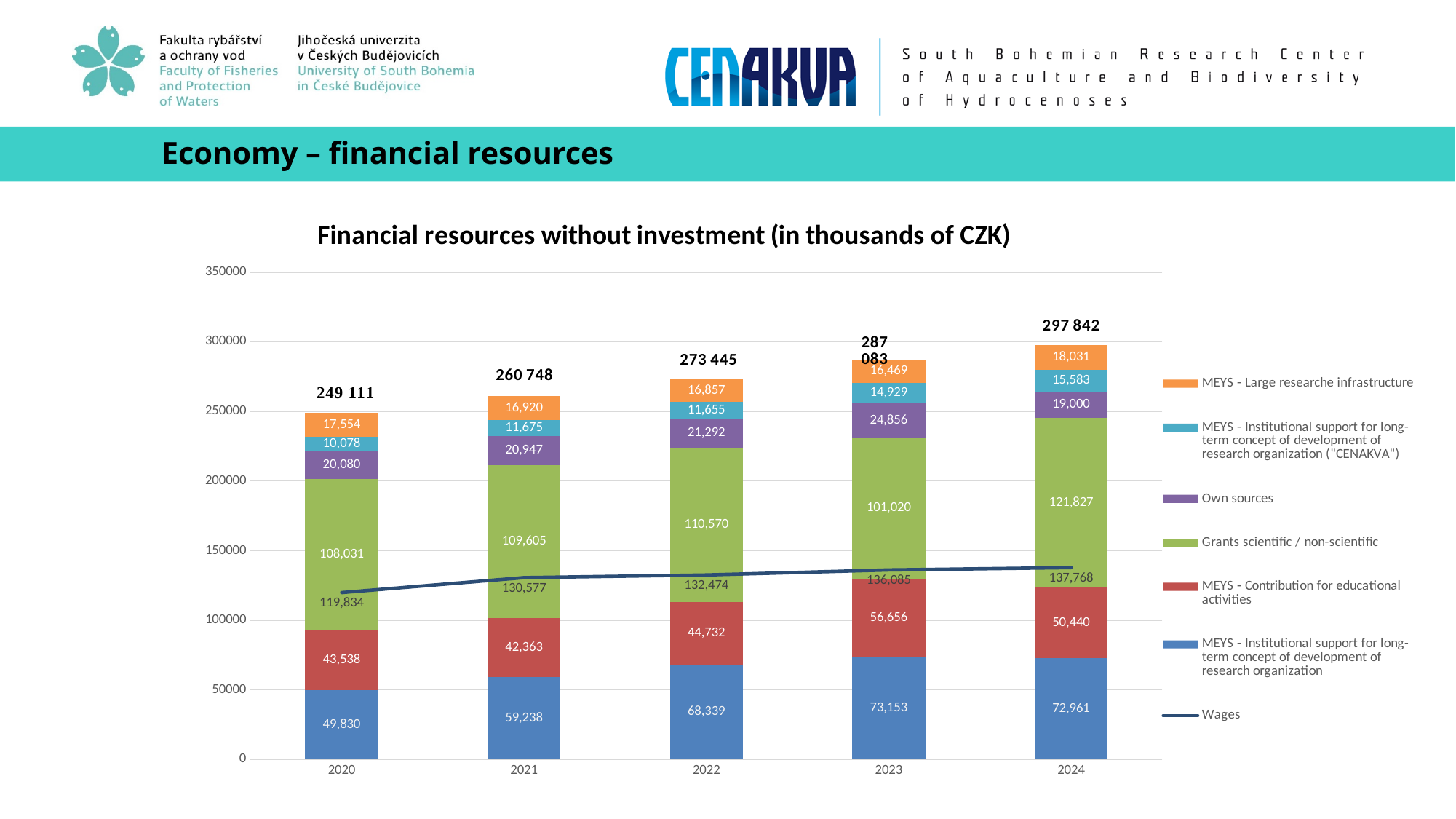
Which year has the highest total financial resources? 2024 In which year is the Own sources value lowest? 2024 Do the total financial resources rise or fall from 2020 to 2024? rise Which year has the larger MEYS - Contribution for educational activities value, 2023 or 2024? 2023 How many series does the legend list? 7 By how much did Wages increase from 2023 to 2024? 1,683 What is the Wages value for 2020? 119,834 What is the value of MEYS - Large researche infrastructure in 2021? 16,920 What is the total of the stacked bar for 2023? 287 083 What is the value of Grants scientific / non-scientific in 2024? 121,827 What is the difference between the MEYS - Institutional support for long-term concept of development of research organization (blue) values in 2023 and 2020? 23,323 How many years are shown on the x axis? 5